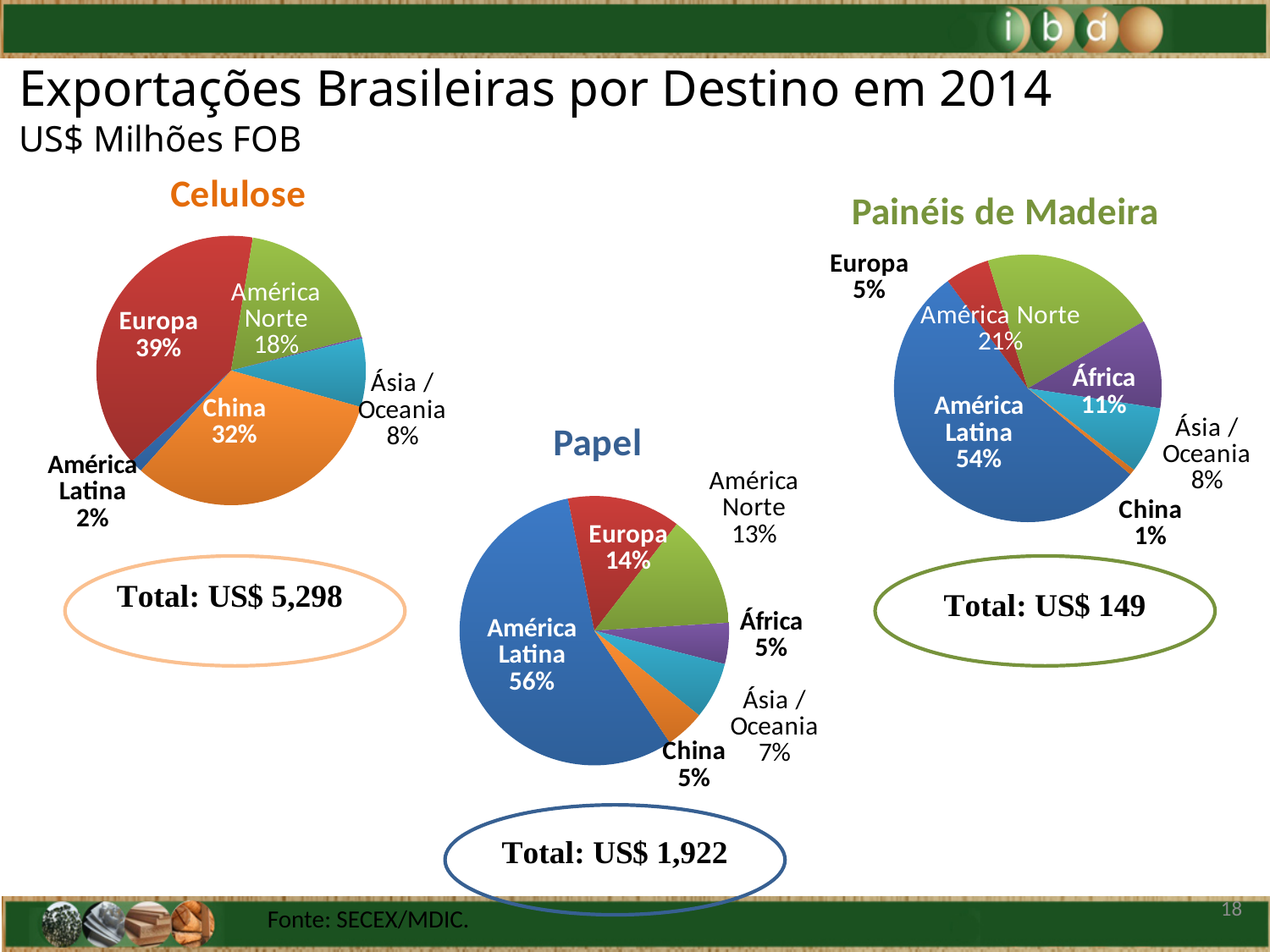
What is the total shown for the Celulose chart? US$ 5,298 How many slices does the Papel pie chart have? 6 What is the total shown for the Papel chart? US$ 1,922 In the Painéis de Madeira chart, what is the difference in percentage points between América Latina and África? 43 In the Celulose chart, what share of exports goes to Europa? 39% In the Papel chart, what share of exports goes to América Latina? 56% What kind of chart is used for Painéis de Madeira? Pie chart In the Papel chart, which is larger, the share for Europa or the share for Ásia / Oceania? Europa In the Celulose chart, what is the difference in percentage points between Europa and China? 7 In the Celulose chart, which destination has the largest share? Europa In the Painéis de Madeira chart, which destination has the smallest share? China In the Painéis de Madeira chart, what share of exports goes to América Norte? 21%